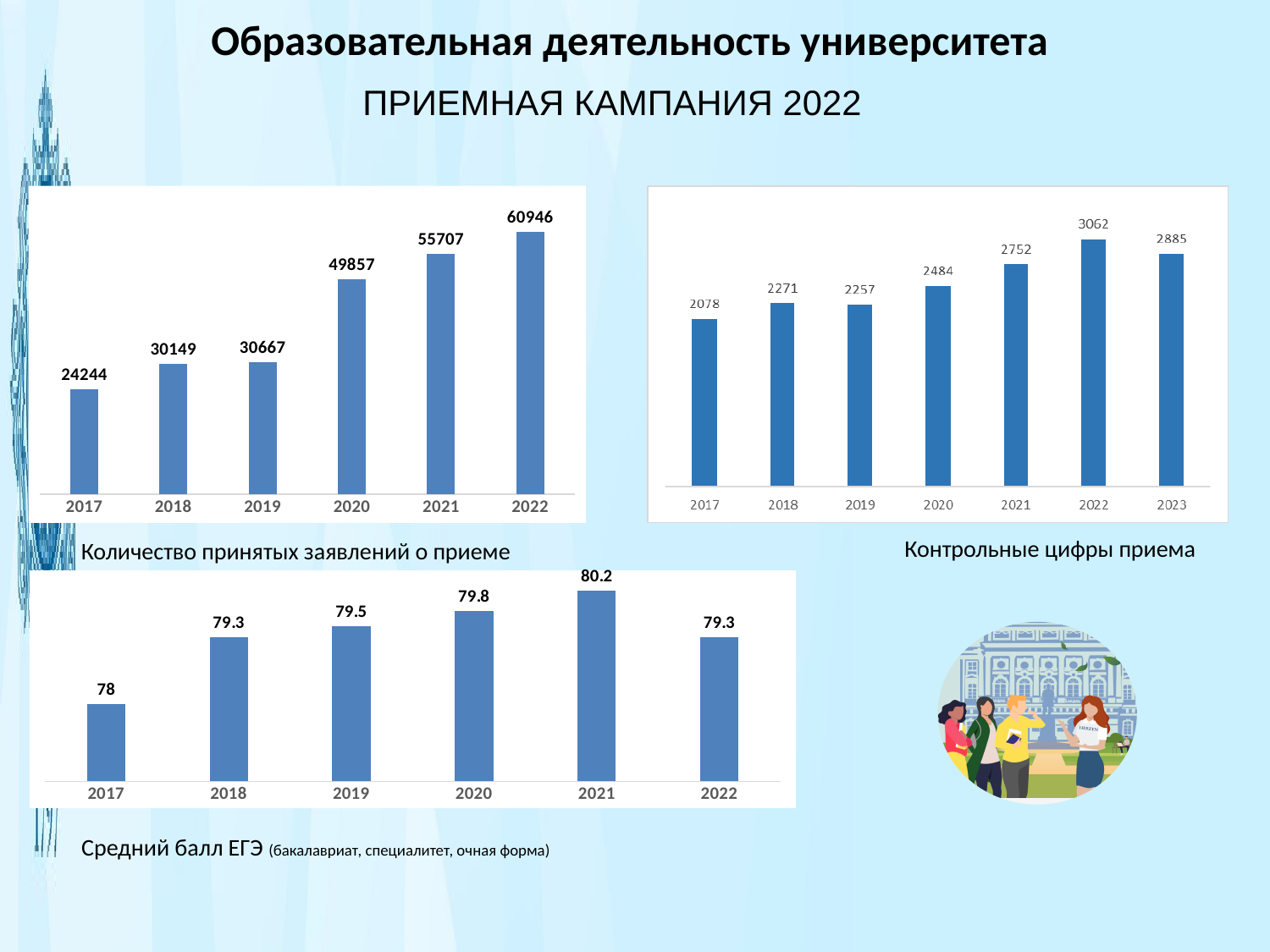
In the chart 'Количество принятых заявлений о приеме', what is the value for 2020? 49857 In the chart 'Количество принятых заявлений о приеме', which year has the highest value? 2022 In the chart 'Контрольные цифры приема', which year has the lowest value? 2017 In the chart 'Средний балл ЕГЭ', which year has the highest value? 2021 In the chart 'Количество принятых заявлений о приеме', what is the difference between the values for 2022 and 2021? 5239 In the chart 'Контрольные цифры приема', what is the value for 2021? 2752 In the chart 'Средний балл ЕГЭ', what is the difference between the values for 2021 and 2017? 2.2 In the chart 'Контрольные цифры приема', which is larger, the value for 2022 or the value for 2023? 2022 In the chart 'Средний балл ЕГЭ', what is the value for 2019? 79.5 In the chart 'Контрольные цифры приема', how many years are shown? 7 In the chart 'Количество принятых заявлений о приеме', how many years are shown? 6 What kind of chart is 'Средний балл ЕГЭ'? Bar chart